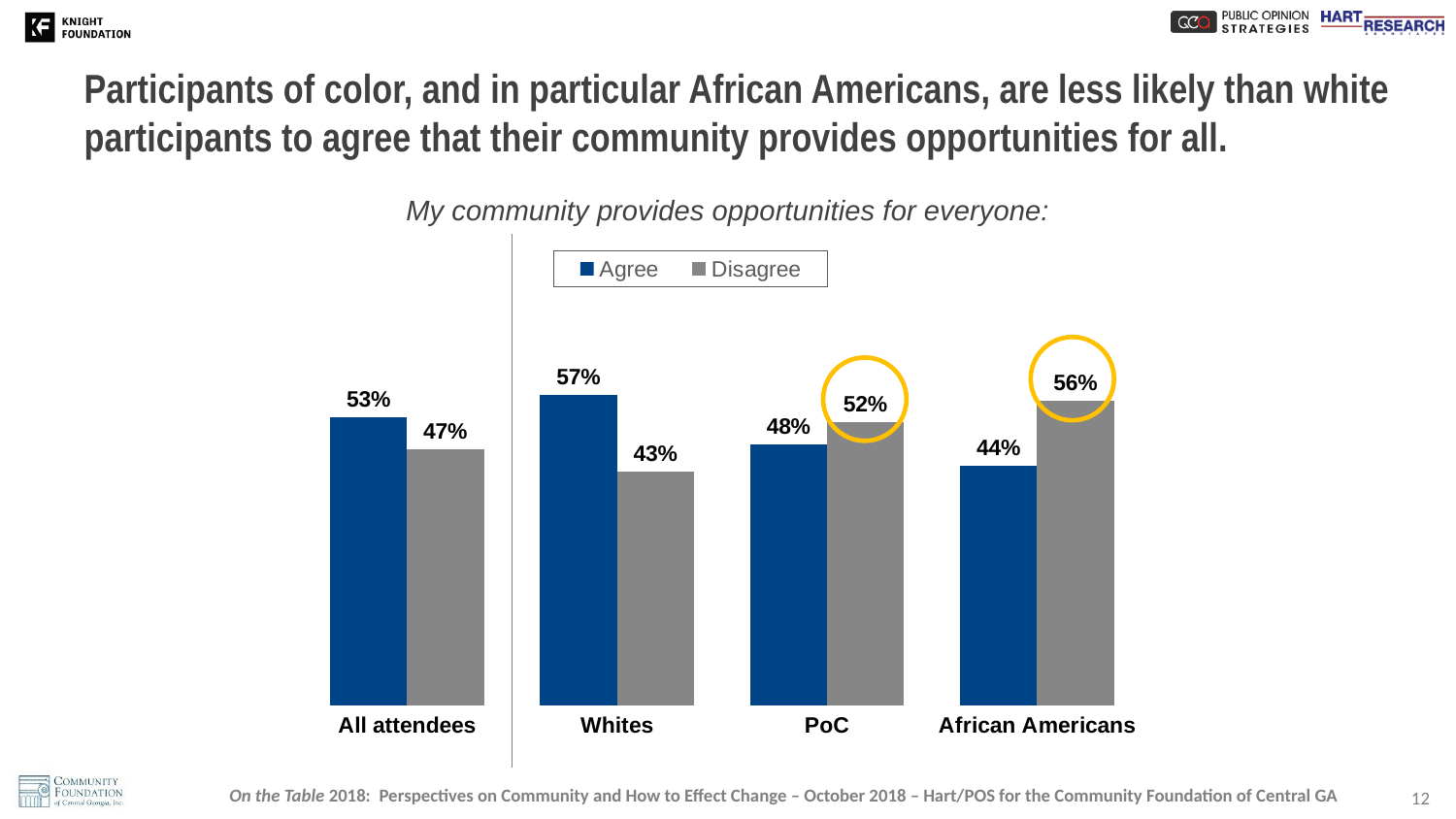
How many series does the legend list? 2 What is the title of the chart? My community provides opportunities for everyone: What kind of chart is shown on the slide? Bar chart What percentage of all attendees agree that their community provides opportunities for everyone? 53% Which group has the lowest Agree percentage? African Americans What percentage of Whites disagree that their community provides opportunities for everyone? 43% What is the Agree value for African Americans? 44% For PoC, which is larger: the Agree or the Disagree percentage? Disagree How many groups are shown on the x axis of the chart? 4 What is the Disagree value for PoC? 52% What is the difference between the Agree percentages for Whites and African Americans? 13 percentage points Which group has the highest Agree percentage? Whites